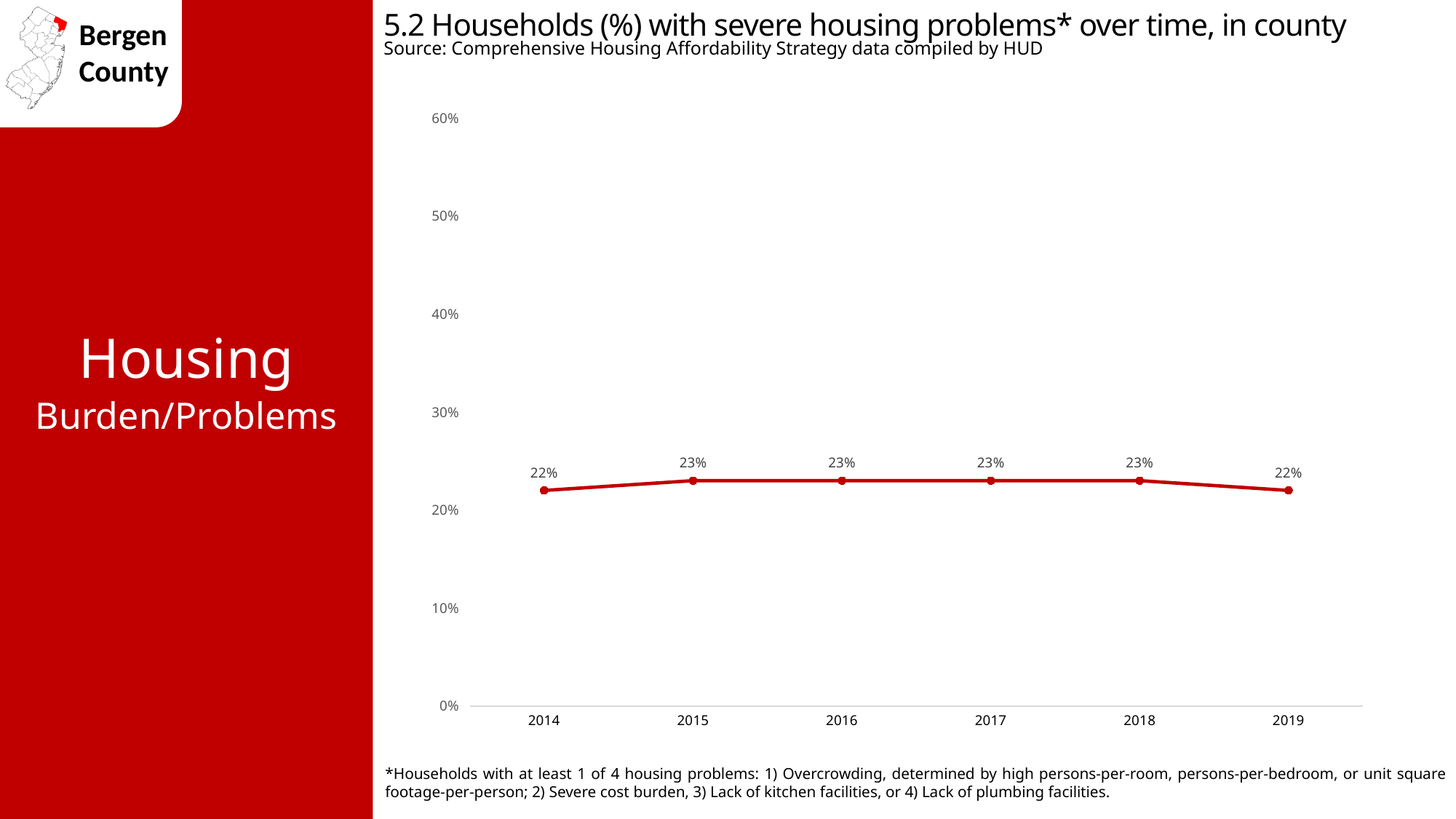
Which is larger, the value for 2015 or the value for 2019? 2015 What is the value for 2014? 22% What is the difference between the values for 2015 and 2014? 1% Is the value for 2017 greater or less than 30%? less What is the value for 2019? 22% What is the value for 2016? 23% What is the title of the chart? 5.2 Households (%) with severe housing problems* over time, in county What is the value for 2018? 23% What is the source of the chart data? Comprehensive Housing Affordability Strategy data compiled by HUD How many years are plotted on the chart? 6 What kind of chart is shown on the slide? Line chart Is the value for 2014 greater or less than 20%? greater